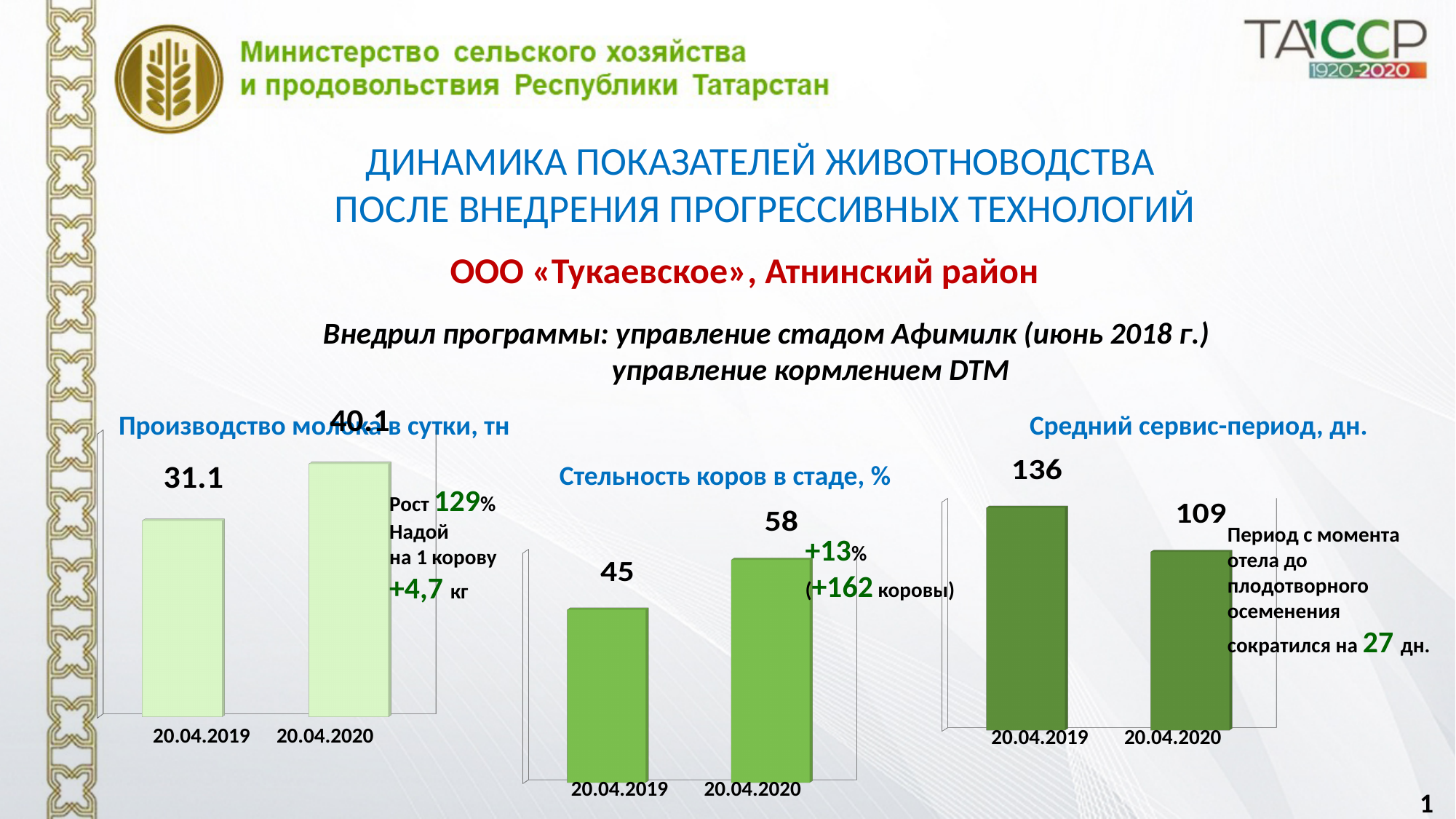
In the chart 'Стельность коров в стаде, %', what is the difference between the 20.04.2020 and 20.04.2019 values? 13 In the chart 'Средний сервис-период, дн.', which date has the lower value? 20.04.2020 In the chart 'Средний сервис-период, дн.', what is the value for 20.04.2019? 136 In the chart 'Производство молока в сутки, тн', what is the value for 20.04.2019? 31.1 In the chart 'Стельность коров в стаде, %', do the values rise or fall from 20.04.2019 to 20.04.2020? rise What type of chart is 'Стельность коров в стаде, %'? bar chart In the chart 'Средний сервис-период, дн.', by how much did the value decrease from 20.04.2019 to 20.04.2020? 27 In the chart 'Средний сервис-период, дн.', what is the value for 20.04.2020? 109 In the chart 'Стельность коров в стаде, %', what is the value for 20.04.2020? 58 How many categories are shown in the chart 'Средний сервис-период, дн.'? 2 In the chart 'Производство молока в сутки, тн', what is the value for 20.04.2020? 40.1 In the chart 'Производство молока в сутки, тн', which date has the higher value? 20.04.2020